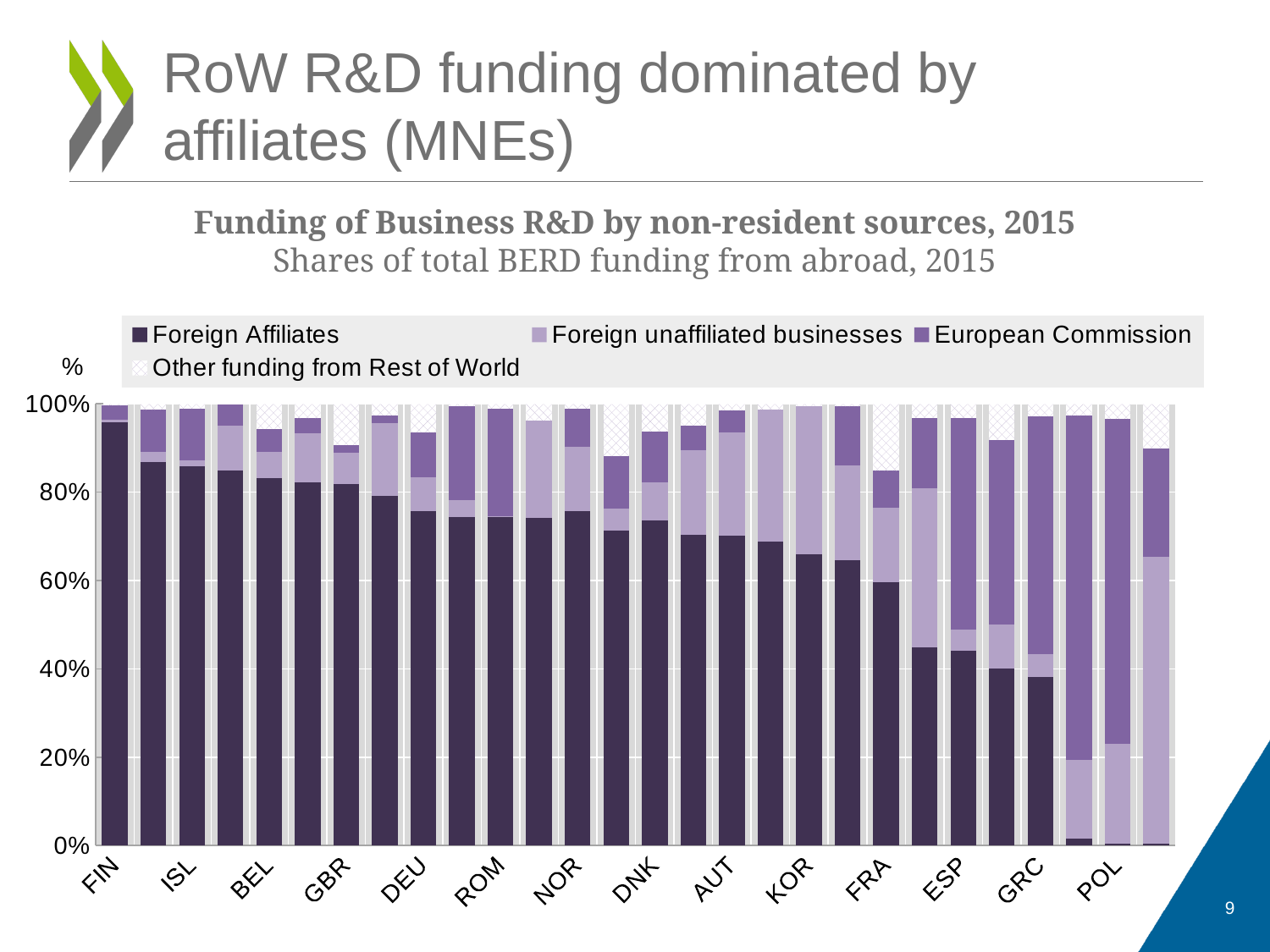
What kind of chart is shown on the slide? stacked bar chart How many series does the legend list? 4 Which has a larger Foreign Affiliates share, BEL or GRC? BEL Is the Foreign Affiliates share for KOR greater or less than 60%? greater Which country has the highest share of Foreign Affiliates funding? FIN What is the title of the chart? Funding of Business R&D by non-resident sources, 2015 Is the Foreign Affiliates share for FIN greater or less than 80%? greater Is the Foreign Affiliates share for ESP greater or less than 60%? less Which has a larger Foreign Affiliates share, FIN or KOR? FIN Does the Foreign Affiliates share rise or fall moving from left to right along the x axis? fall